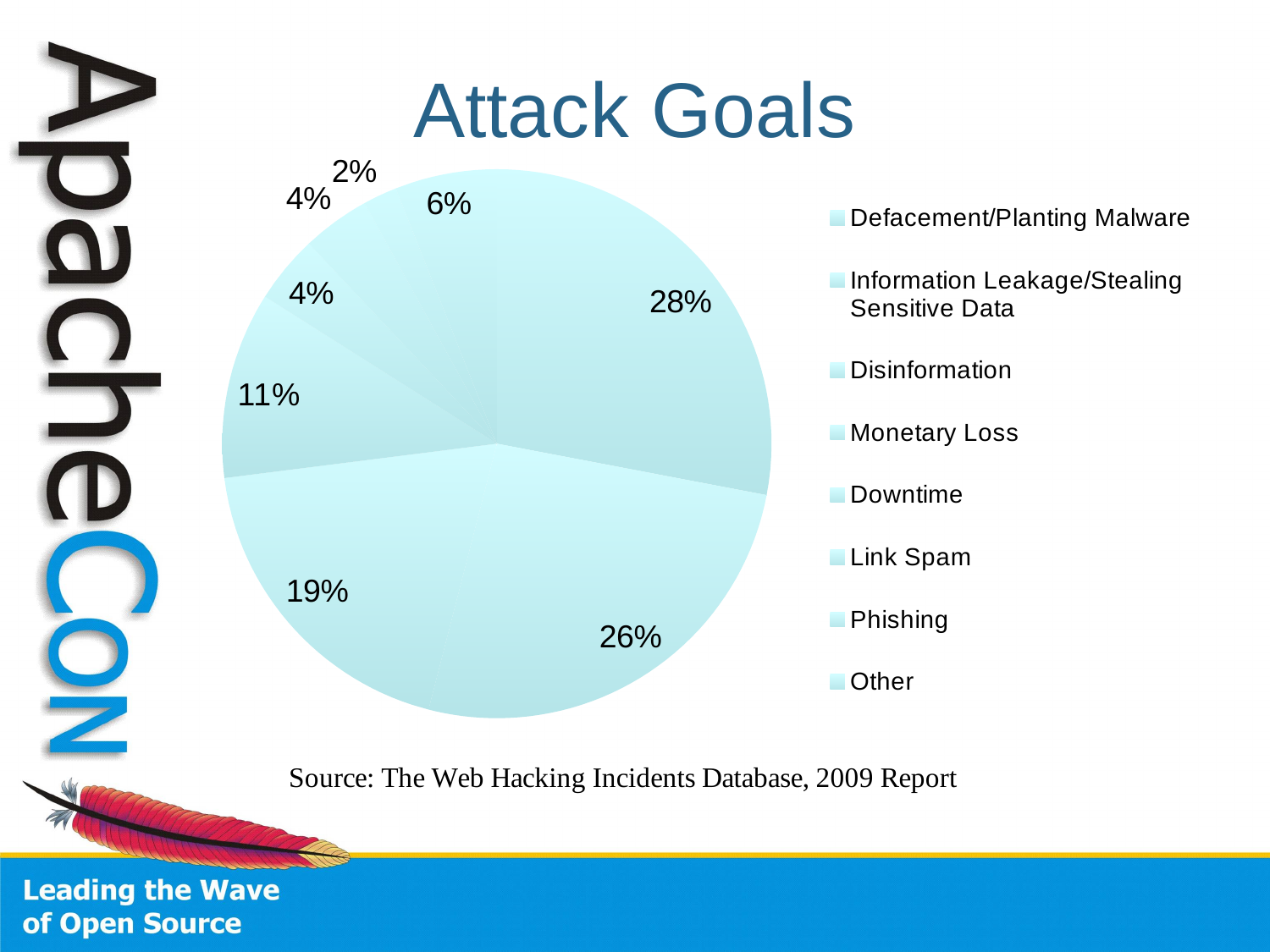
What is the percentage shown on the largest slice of the pie chart? 28% What is the title of the chart on the slide? Attack Goals What is the difference between the largest slice (28%) and the second-largest slice (26%)? 2 percentage points What kind of chart is shown on the slide? pie chart How many slices does the pie chart have? 8 How many slices of the pie chart are labelled 4%? 2 What is the first entry listed in the chart's legend? Defacement/Planting Malware Which is larger, the slice labelled 19% or the slice labelled 11%? 19% What is the percentage shown on the smallest slice of the pie chart? 2% What is the difference between the 26% slice and the 19% slice? 7 percentage points What is the combined share of the two largest slices, 28% and 26%? 54% How many entries does the legend of the pie chart list? 8